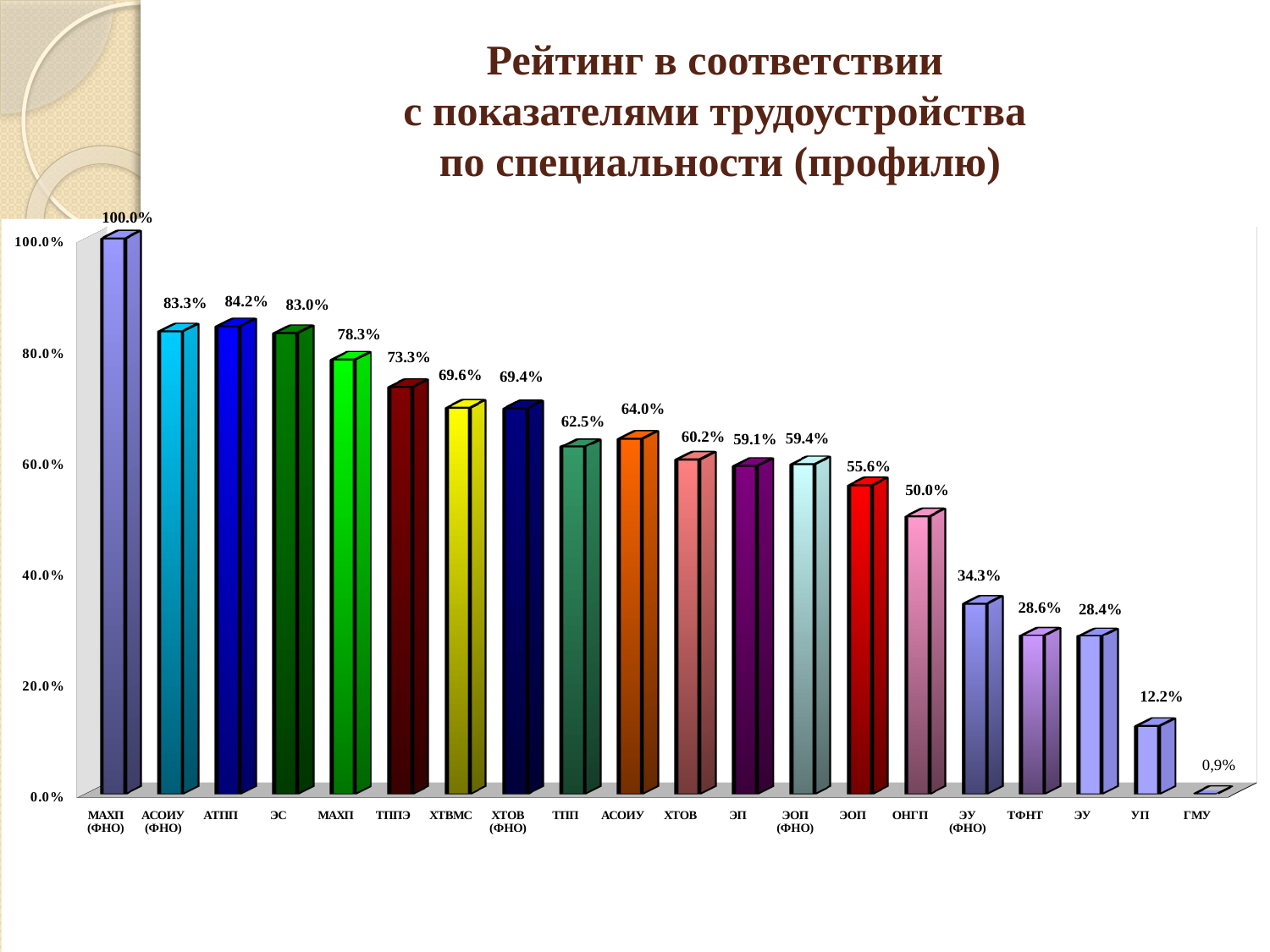
Which category has the lowest value? ГМУ What is the value for ЭУ (ФНО)? 34.3% What is the value for ОНГП? 50.0% How many categories are shown on the x axis? 20 Do the values generally rise or fall from left to right along the x axis? fall What is the value for АТПП? 84.2% What is the value for ГМУ? 0,9% What is the difference between the values for ТППЭ and ХТВМС? 3.7% What kind of chart is shown on the slide? bar chart Is the value for УП greater or less than 20.0%? less Which is larger, the value for ЭС or the value for МАХП? ЭС Which category has the highest value? МАХП (ФНО)